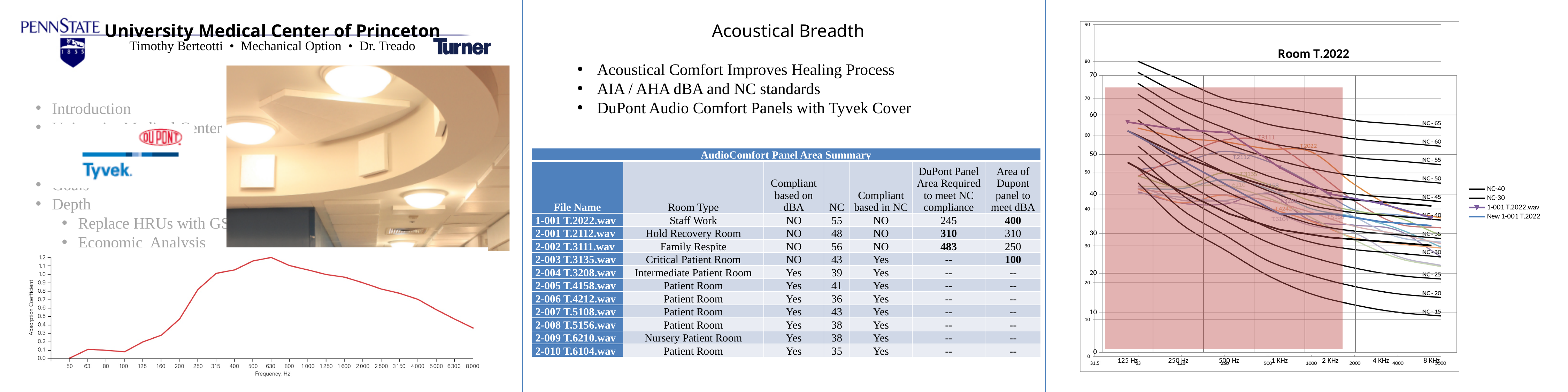
On the bottom-left Absorption Coefficient chart, which has the larger absorption coefficient, 250 Hz or 4000 Hz? 250 Hz On the bottom-left Absorption Coefficient chart, is the value at 100 Hz greater or less than 0.5? less On the bottom-left Absorption Coefficient chart, is the value at 630 Hz greater or less than 1.0? greater What kind of chart is the Room T.2022 chart? line chart What kind of chart is the bottom-left chart showing Absorption Coefficient against Frequency? line chart On the bottom-left Absorption Coefficient chart, does the absorption coefficient rise or fall between 50 Hz and 630 Hz? rise On the bottom-left Absorption Coefficient chart, at which frequency is the absorption coefficient lowest? 50 Hz On the bottom-left Absorption Coefficient chart, is the value at 8000 Hz greater or less than 0.5? less How many series does the legend of the Room T.2022 chart list? 4 What is the title of the chart on the right side of the slide? Room T.2022 On the bottom-left Absorption Coefficient chart, at which frequency does the absorption coefficient reach its highest value? 630 Hz On the Room T.2022 chart, do the NC curves rise or fall as frequency increases along the x axis? fall